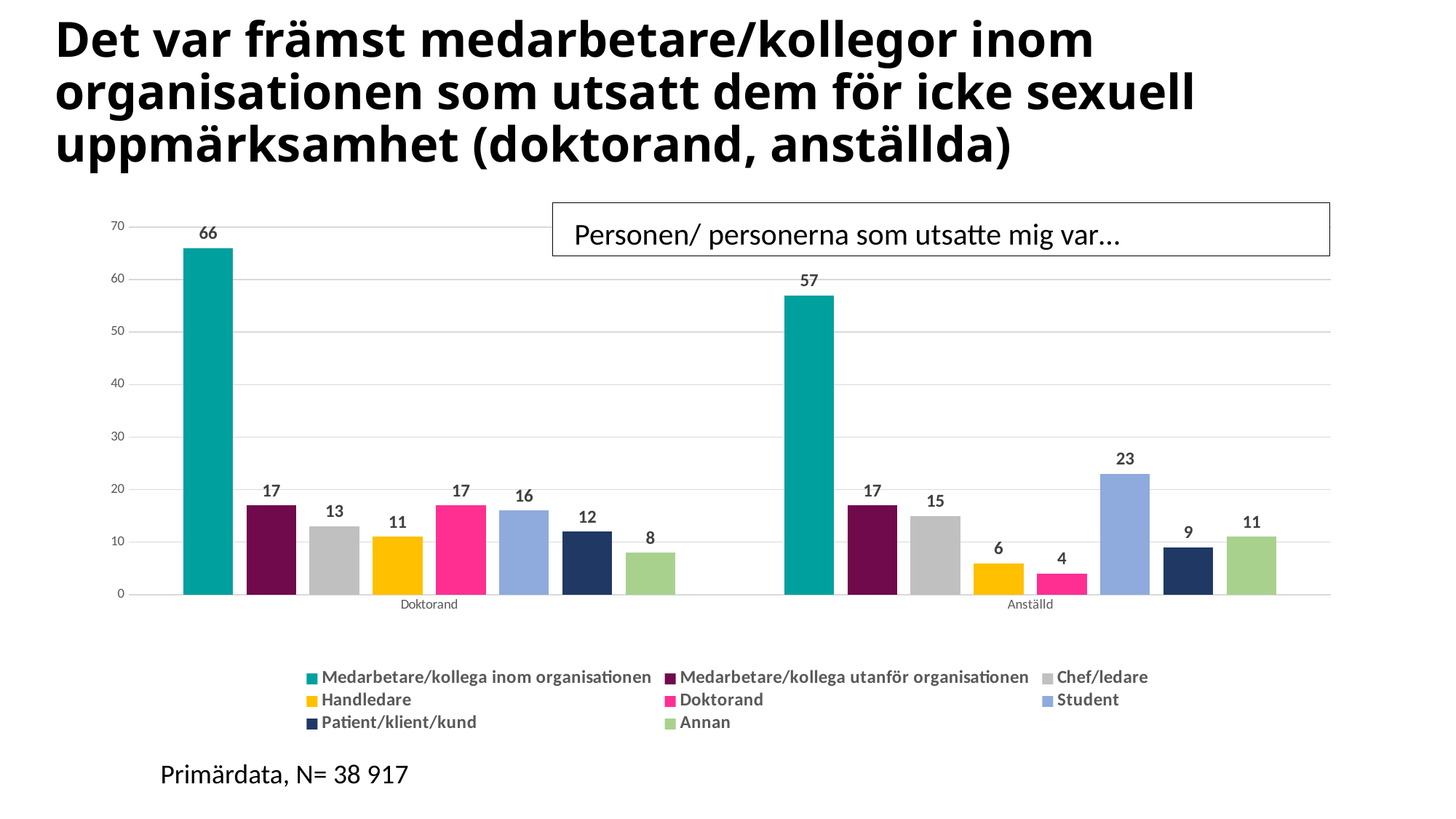
How many series does the legend list? 8 What is the value for Student in the Anställd group? 23 What is the text in the box above the chart? Personen/ personerna som utsatte mig var… What is the difference between the Medarbetare/kollega inom organisationen values for Doktorand and Anställd? 9 What is the value for Annan in the Doktorand group? 8 Which series has the lowest value in the Anställd group? Doktorand What is the value for Handledare in the Anställd group? 6 Which is larger: the Student value for Doktorand or for Anställd? Anställd Which series has the highest value in the Anställd group? Medarbetare/kollega inom organisationen Is the value for Chef/ledare in the Anställd group greater or less than 20? less What is the value for Medarbetare/kollega inom organisationen in the Doktorand group? 66 What kind of chart is shown on the slide? Bar chart